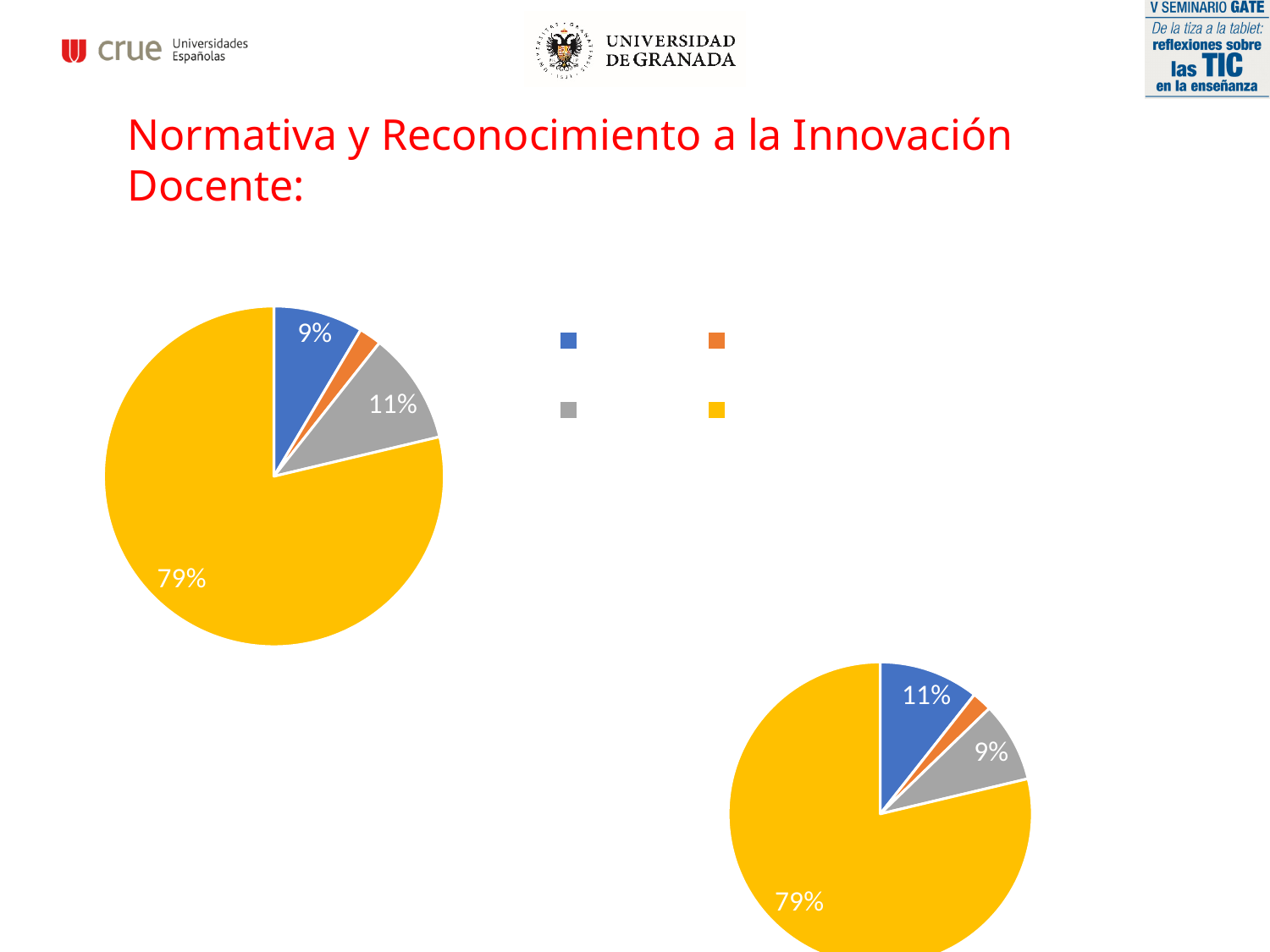
In the top-left pie chart, what is the difference between the gray slice and the blue slice? 2 percentage points In the bottom-right pie chart, what is the value of the largest slice? 79% In the bottom-right pie chart, what value is shown on the blue slice? 11% How many entries does the legend next to the top-left pie chart show? 4 In the top-left pie chart, what value is shown on the gray slice? 11% How many slices does the top-left pie chart have? 4 In the top-left pie chart, what value is shown on the blue slice? 9% What kind of chart is the chart on the bottom right of the slide? pie chart What kind of chart is the chart on the top left of the slide? pie chart In the bottom-right pie chart, what value is shown on the gray slice? 9% In the top-left pie chart, which is larger, the blue slice or the gray slice? the gray slice In the top-left pie chart, what is the value of the largest slice? 79%